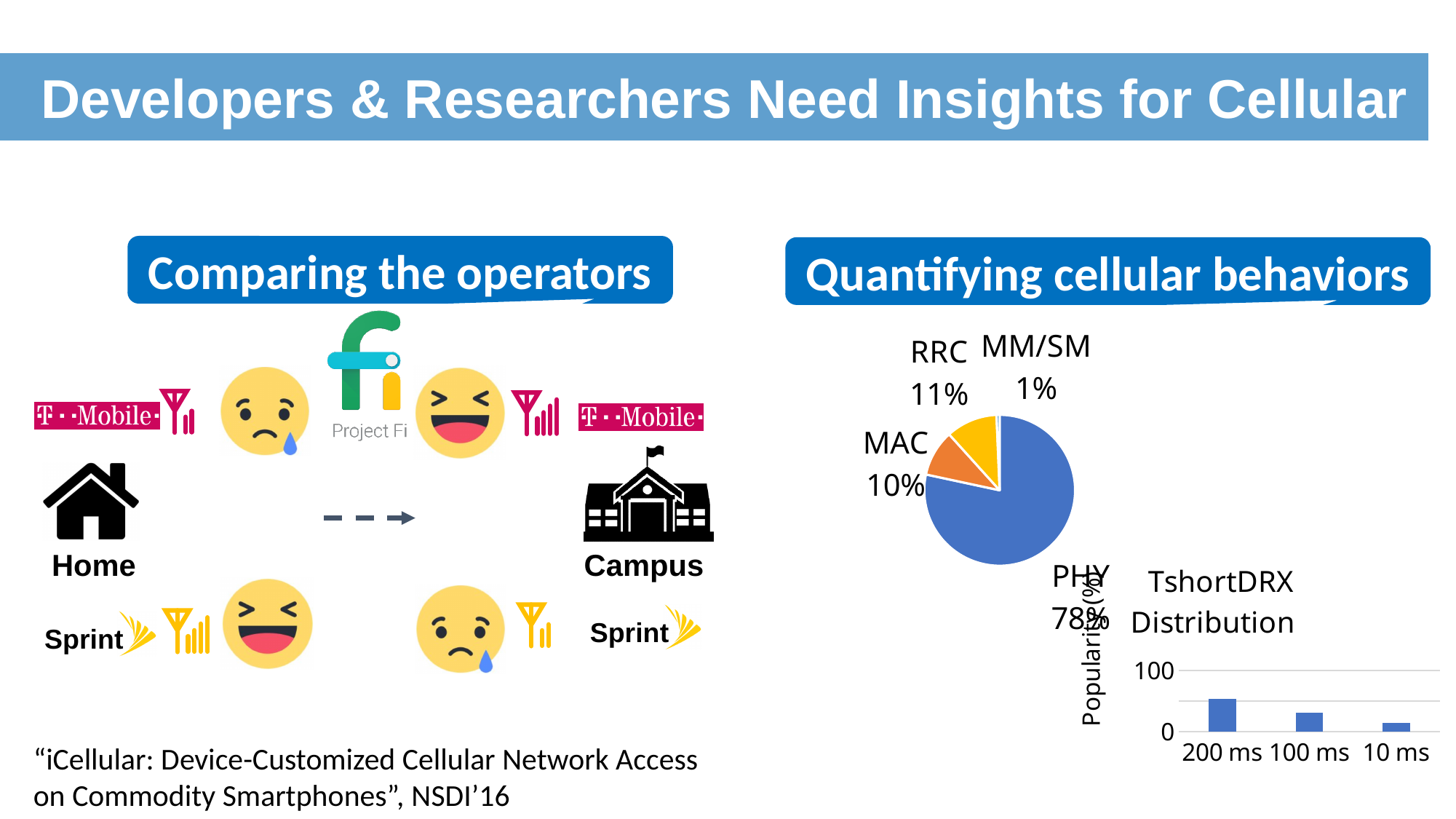
In the pie chart, what share does PHY have? 78% In the pie chart, which category has the largest slice? PHY How many slices does the pie chart have? 4 What is the title of the bar chart? TshortDRX Distribution In the TshortDRX Distribution chart, which category has the lowest bar? 10 ms In the pie chart, what share does RRC have? 11% In the pie chart, what share does MM/SM have? 1% In the pie chart, what share does MAC have? 10% In the TshortDRX Distribution chart, is the value for 200 ms greater or less than 100? less In the TshortDRX Distribution chart, which category has the highest bar? 200 ms In the pie chart, what is the difference between the PHY share and the RRC share? 67% In the pie chart, which category has the smallest slice? MM/SM